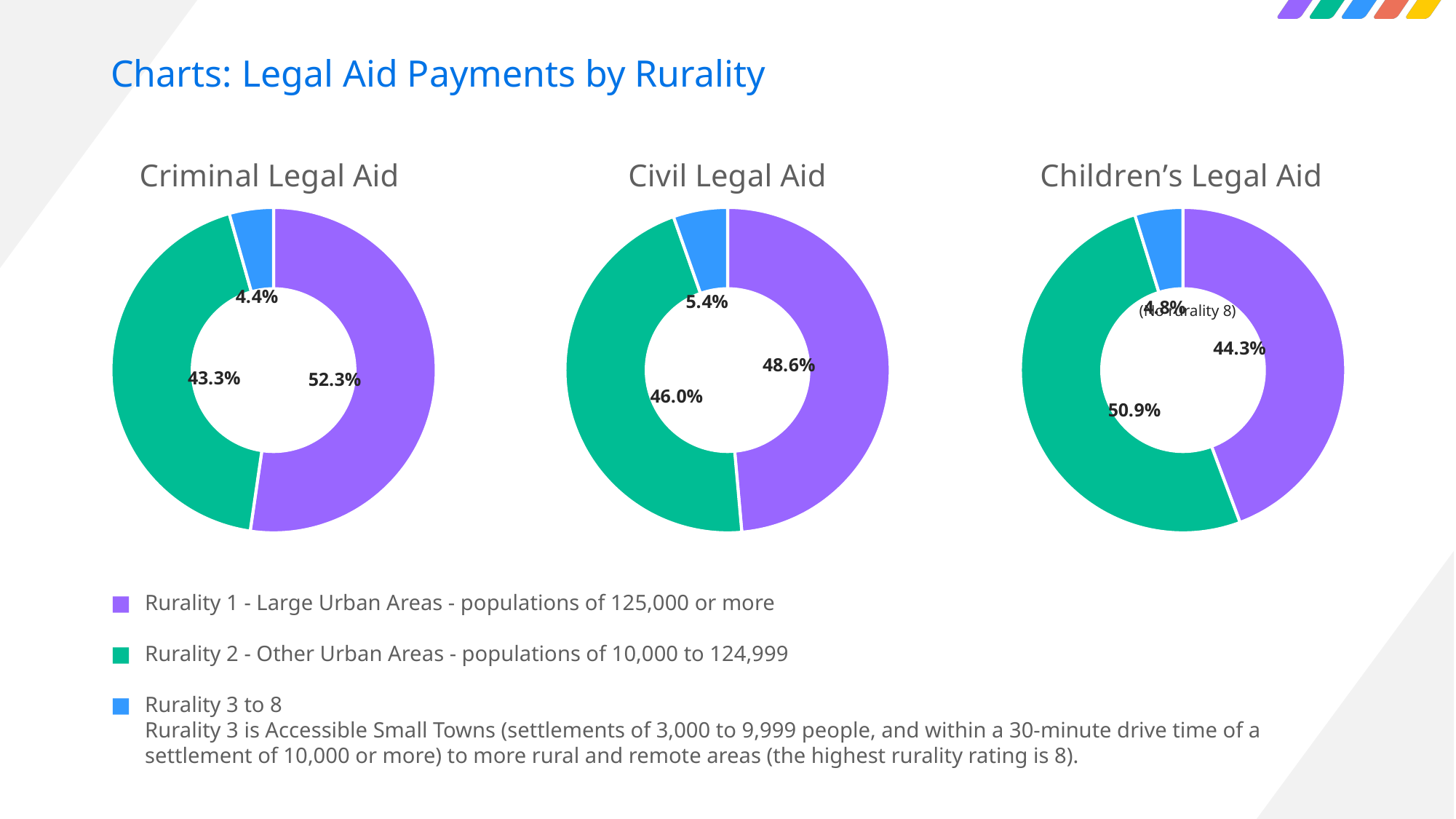
In the Civil Legal Aid chart, what share of payments goes to Rurality 3 to 8? 5.4% In the Criminal Legal Aid chart, what share of payments goes to Rurality 1 - Large Urban Areas? 52.3% Is the Rurality 1 share larger in the Criminal Legal Aid chart or the Civil Legal Aid chart? Criminal Legal Aid In the Children's Legal Aid chart, which rurality category has the largest share? Rurality 2 - Other Urban Areas How many rurality categories does the legend list? 3 In the Criminal Legal Aid chart, which rurality category has the smallest share? Rurality 3 to 8 In the Children's Legal Aid chart, what share of payments goes to Rurality 2 - Other Urban Areas? 50.9% In the Criminal Legal Aid chart, what share of payments goes to Rurality 3 to 8? 4.4% What kind of chart is used for Criminal Legal Aid, Civil Legal Aid and Children's Legal Aid? Pie (donut) chart In the Civil Legal Aid chart, what share of payments goes to Rurality 1 - Large Urban Areas? 48.6% In the Civil Legal Aid chart, what is the difference between the Rurality 1 share and the Rurality 2 share? 2.6% In the Criminal Legal Aid chart, what share of payments goes to Rurality 2 - Other Urban Areas? 43.3%